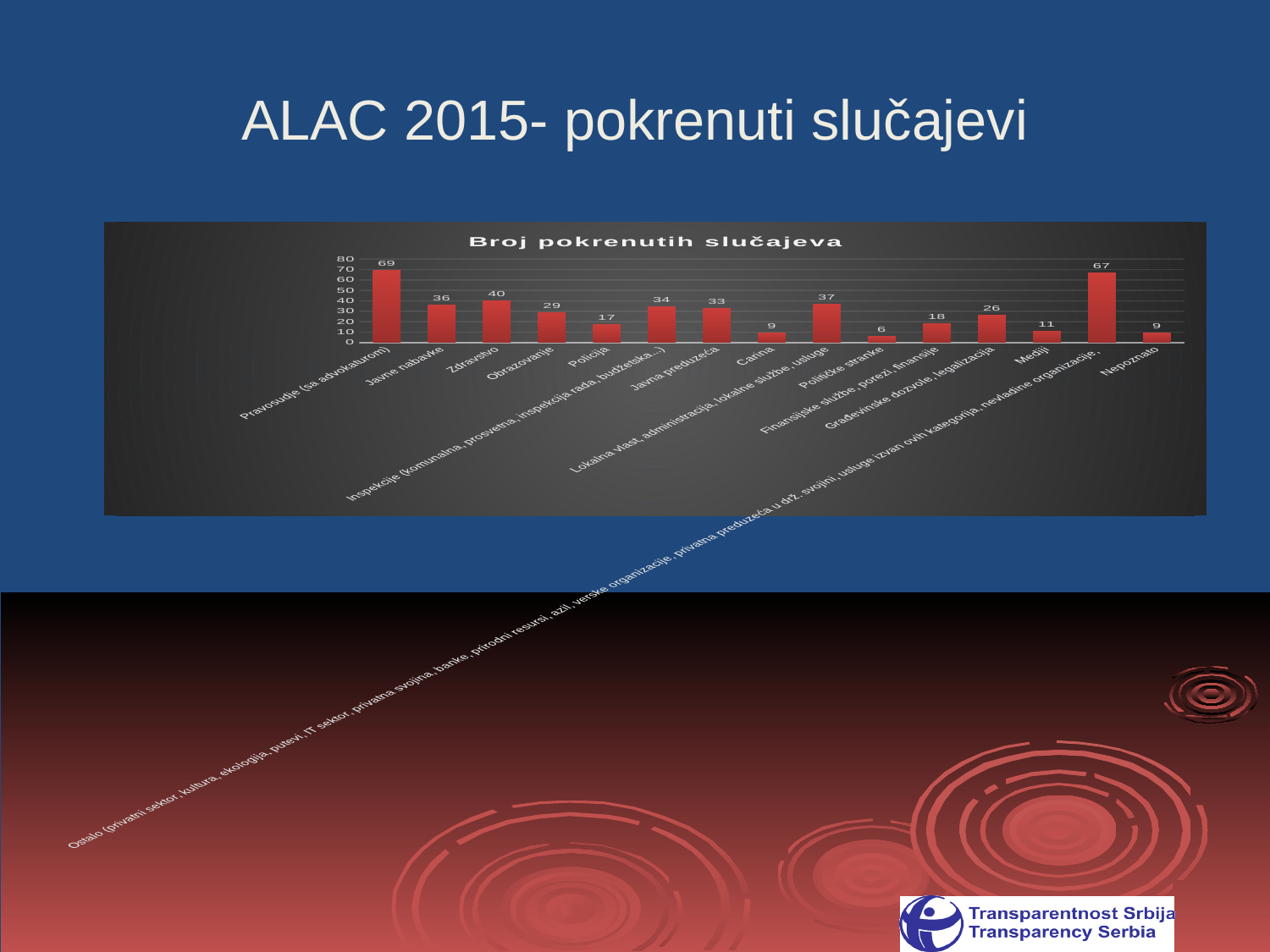
What is the value for Mediji? 11 Which category has the lowest value? Političke stranke What is the value for Pravosuđe (sa advokaturom)? 69 How many categories are shown on the x axis? 15 Which is larger, the value for Zdravstvo or the value for Obrazovanje? Zdravstvo What is the value for Policija? 17 What is the value for Građevinske dozvole, legalizacija? 26 Which category has the highest value? Pravosuđe (sa advokaturom) What kind of chart is this? Bar chart What is the value for Zdravstvo? 40 What is the title of the chart? Broj pokrenutih slučajeva What is the difference between the values for Pravosuđe (sa advokaturom) and Javne nabavke? 33